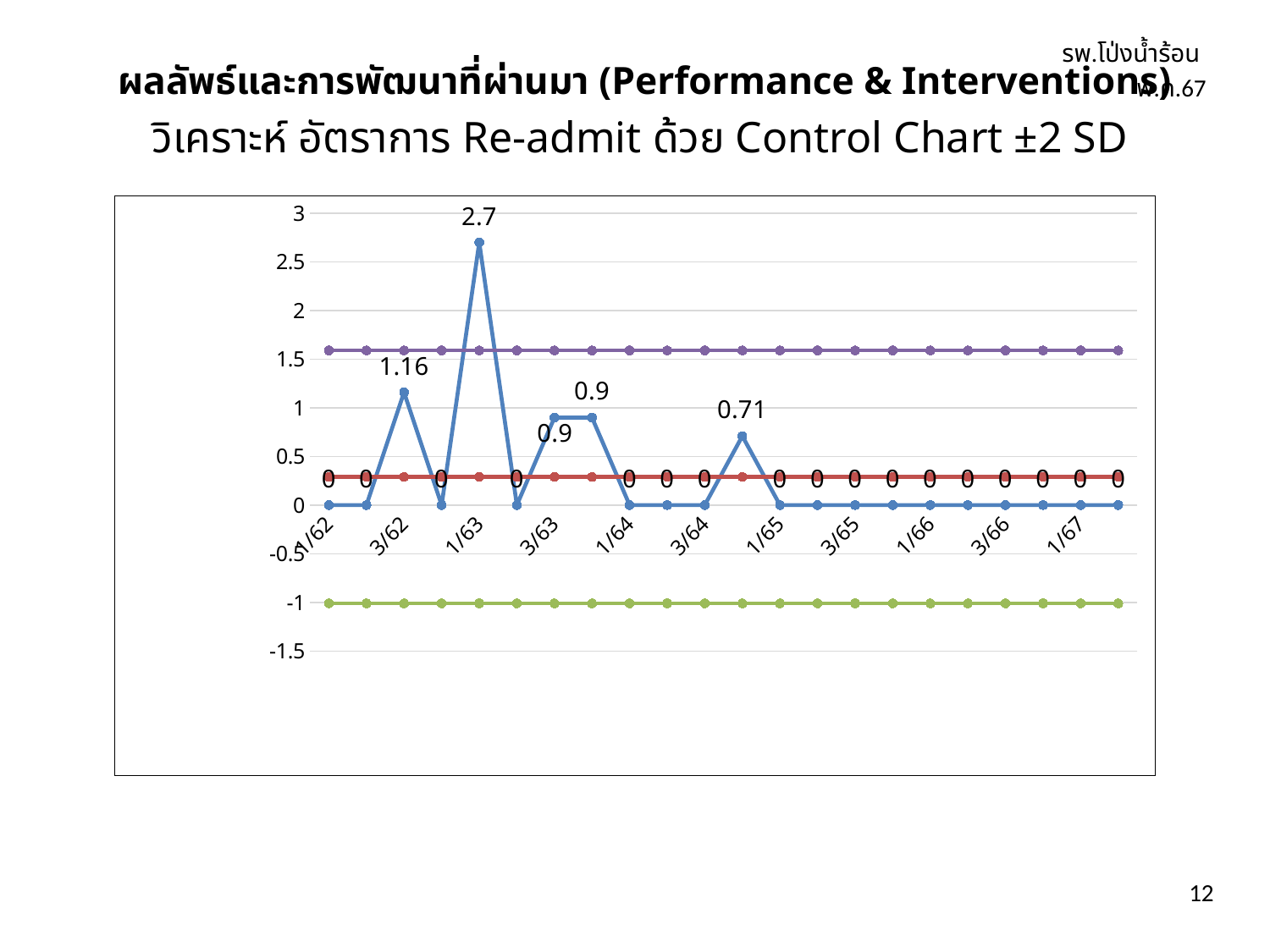
How many labels are shown on the x axis? 11 What is the Re-admit rate value at 1/64? 0 What is the Re-admit rate value at 3/63? 0.9 What is the Re-admit rate value at 1/63? 2.7 What is the highest data value labelled on the chart? 2.7 Which is larger, the Re-admit rate at 1/63 or at 3/63? 1/63 Is the Re-admit rate at 1/63 greater or less than 2? greater What type of chart is shown on the slide? line chart At which x-axis label does the Re-admit rate reach its highest value? 1/63 Is the green lower control line greater or less than -0.5? less What is the difference between the Re-admit rate at 1/63 and at 3/63? 1.8 Is the purple upper control line greater or less than 1.5? greater